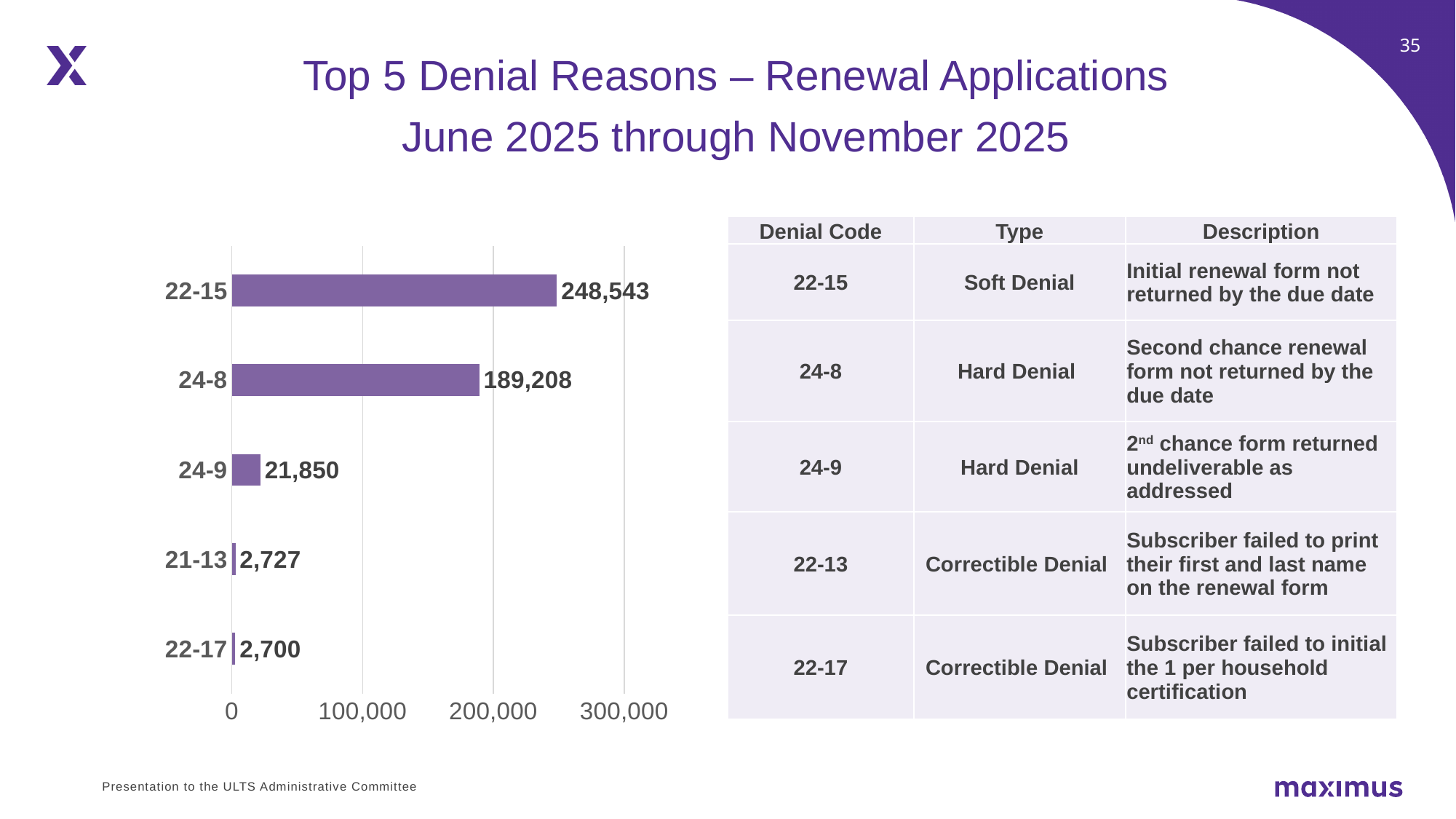
Which denial code has the lowest value? 22-17 Is the value for 24-8 greater or less than 200,000? less What is the difference between the values for 22-15 and 24-8? 59,335 What is the difference between the values for 21-13 and 22-17? 27 Which denial code has the highest value? 22-15 What is the value for denial code 24-9? 21,850 Which is larger, the value for 24-8 or the value for 24-9? 24-8 What is the value for denial code 24-8? 189,208 How many denial codes are shown in the chart? 5 What is the value for denial code 22-17? 2,700 What kind of chart is shown on the slide? bar chart What is the value for denial code 22-15? 248,543